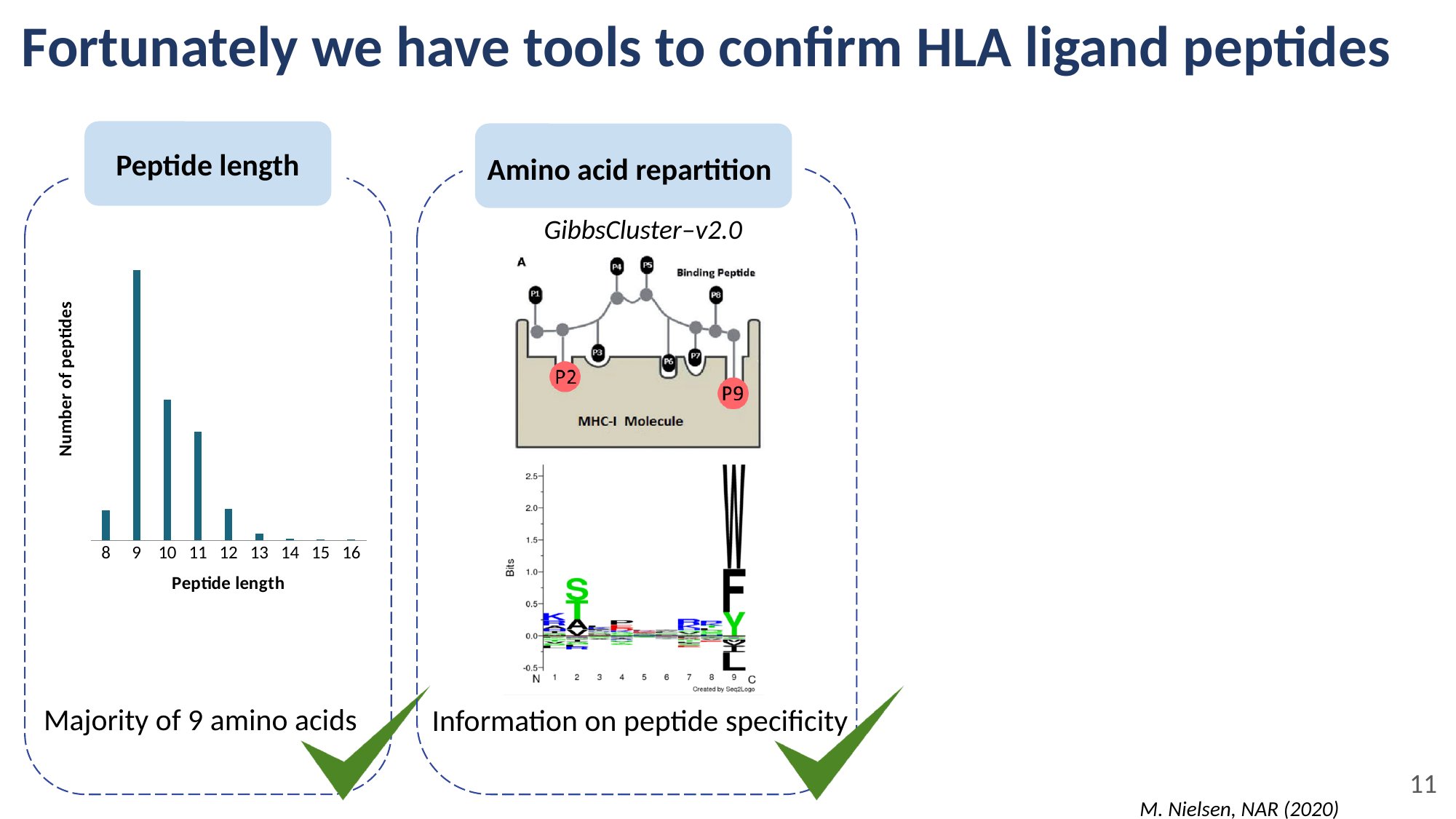
In the Peptide length chart, which has more peptides: length 10 or length 11? 10 In the Peptide length chart, which has more peptides: length 9 or length 10? 9 What kind of chart is the Peptide length chart on the left of the slide? bar chart What is the y-axis title of the Peptide length chart? Number of peptides In the Peptide length chart, which has more peptides: length 12 or length 10? 10 How many peptide length categories are shown on the x axis of the Peptide length chart? 9 In the Peptide length chart, which peptide length has the highest number of peptides? 9 What is the x-axis title of the bar chart on the left of the slide? Peptide length In the Peptide length chart, do the bar values rise or fall as peptide length increases from 9 to 13? fall